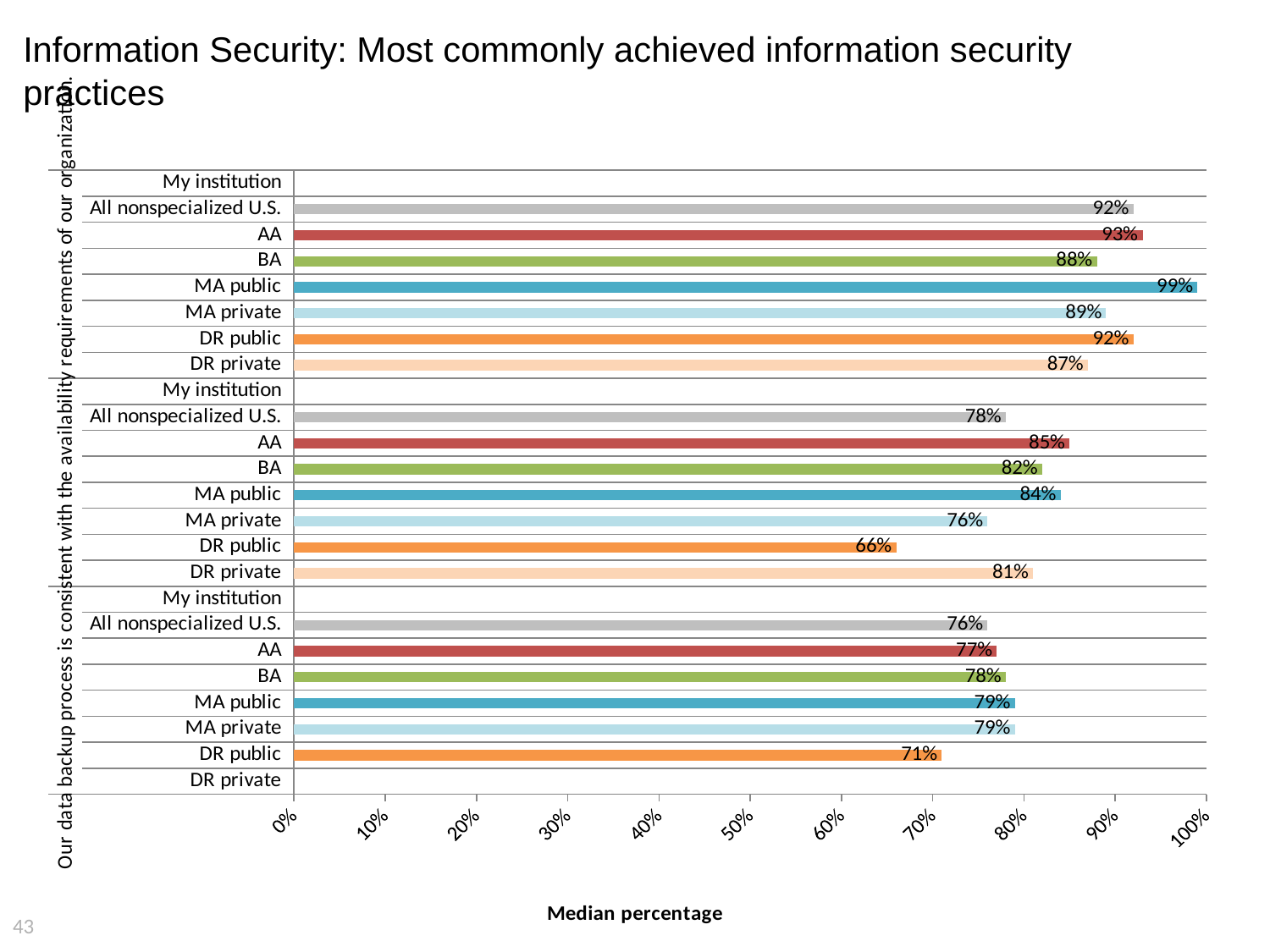
What type of chart is shown on the slide? bar chart In the top group of bars, what is the difference between the MA public value and the BA value? 11% What is the x-axis title of the chart? Median percentage In the top group of bars, what is the value for MA public? 99% In the middle group of bars, what is the difference between the AA value and the DR public value? 19% In the middle group of bars, which category has the highest value? AA In the middle group of bars, what is the value for DR public? 66% In the middle group of bars, which category has the lowest value? DR public In the bottom group of bars, which is larger: the value for BA or the value for DR public? BA In the top group of bars, which category has the highest value? MA public In the bottom group of bars, what is the value for All nonspecialized U.S.? 76% In the top group of bars, what is the value for DR private? 87%